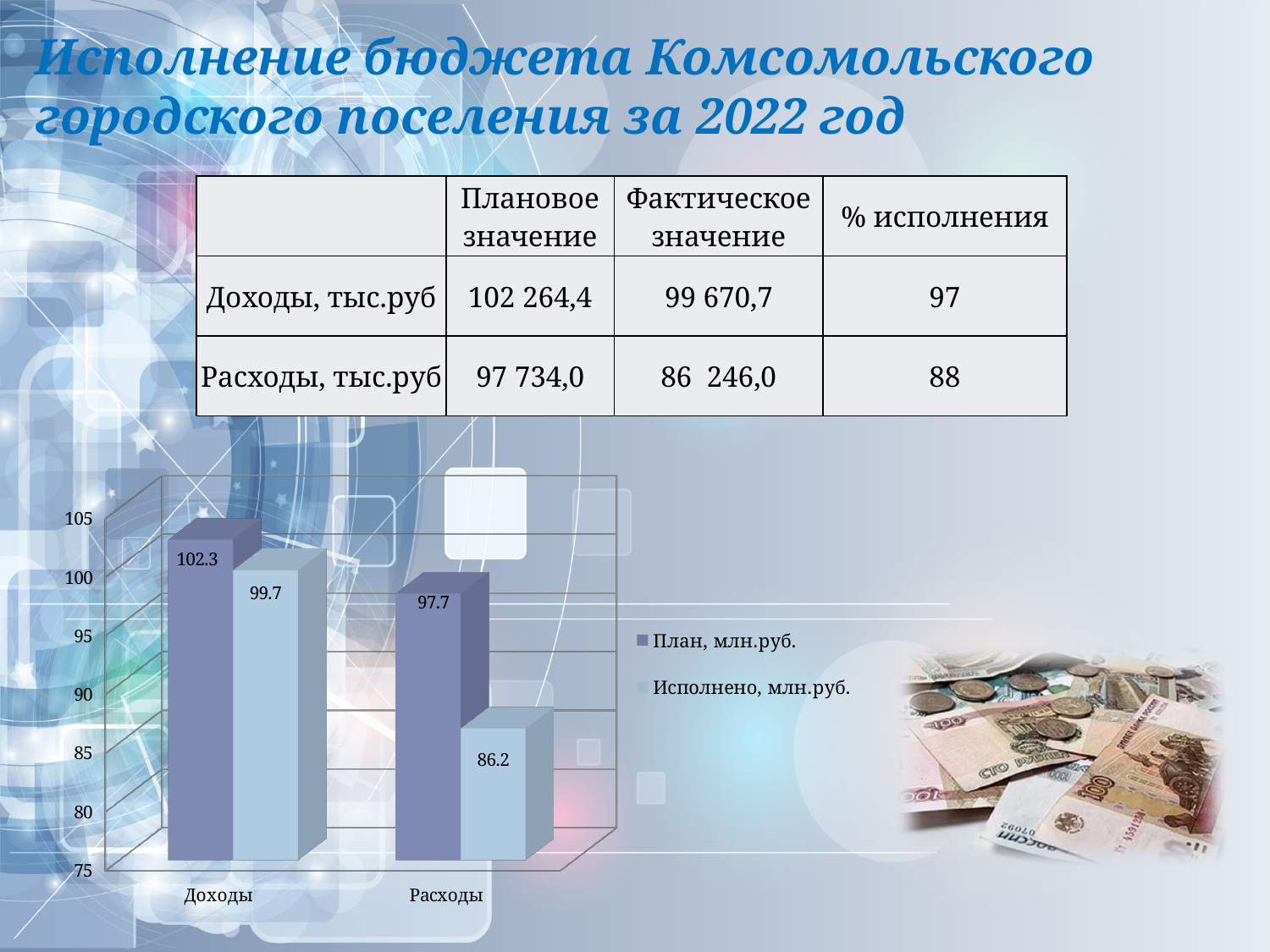
In the chart, is the 'Исполнено, млн.руб.' value for 'Доходы' larger or smaller than the 'План, млн.руб.' value for 'Расходы'? larger What is the value of the 'Исполнено, млн.руб.' series for 'Доходы' in the chart? 99.7 What is the value of the 'Исполнено, млн.руб.' series for 'Расходы' in the chart? 86.2 How many categories are shown on the x axis of the chart? 2 Which category has the lowest 'Исполнено, млн.руб.' value in the chart? Расходы What type of chart is shown on the slide? bar chart What is the value of the 'План, млн.руб.' series for 'Доходы' in the chart? 102.3 What is the difference between the 'План, млн.руб.' and 'Исполнено, млн.руб.' values for 'Доходы' in the chart? 2.6 How many series does the chart's legend list? 2 What is the difference between the 'План, млн.руб.' and 'Исполнено, млн.руб.' values for 'Расходы' in the chart? 11.5 Which category has the highest 'План, млн.руб.' value in the chart? Доходы What is the value of the 'План, млн.руб.' series for 'Расходы' in the chart? 97.7